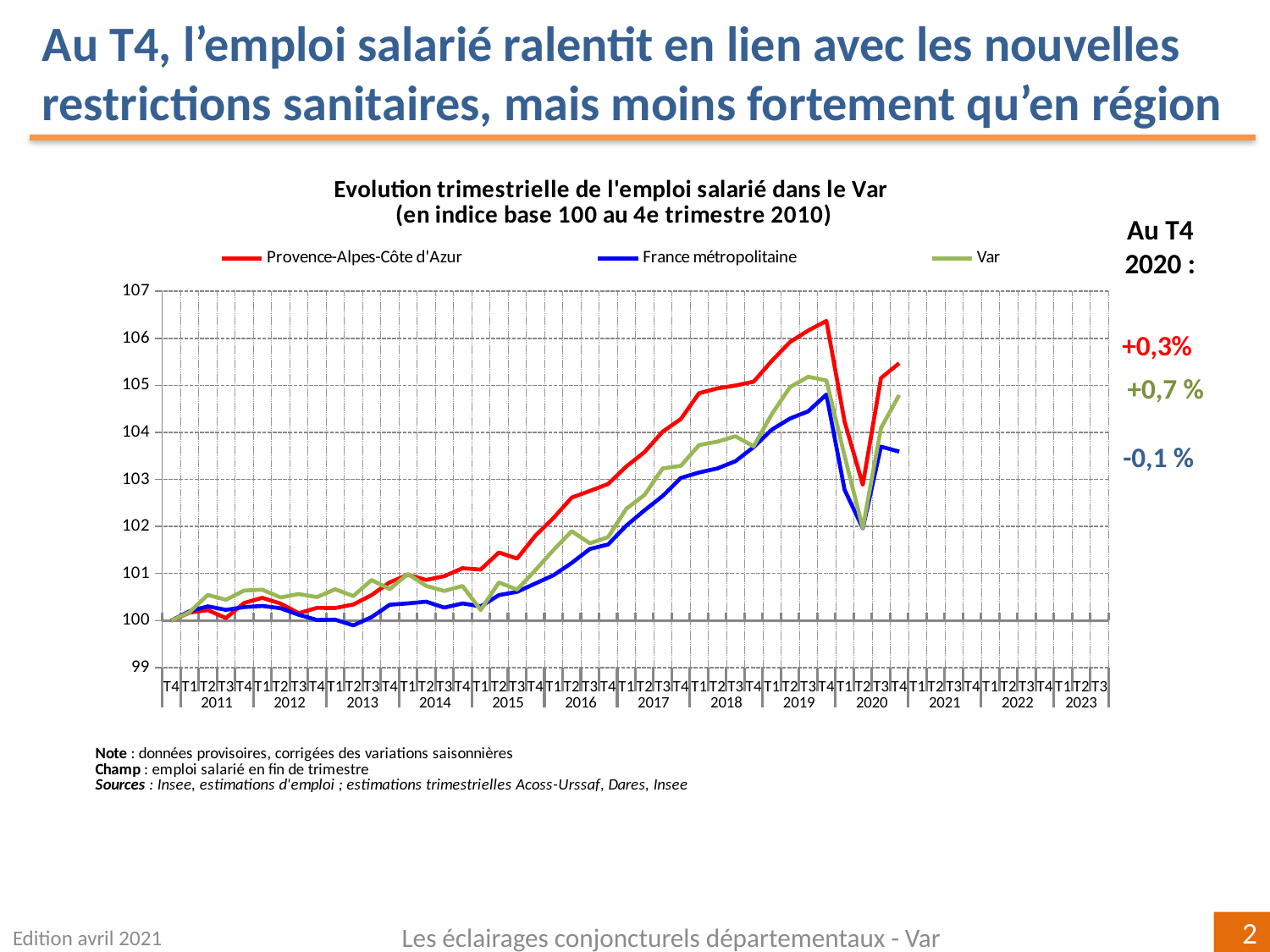
Is the value for Provence-Alpes-Côte d'Azur at T4 2019 greater or less than 106? greater How many series does the legend list? 3 Which series are listed in the legend? Provence-Alpes-Côte d'Azur, France métropolitaine, Var What kind of chart is shown on the slide? line chart According to the annotation for T4 2020, what is the change for France métropolitaine? -0,1 % Overall, do the index values rise or fall from T4 2010 to T4 2019? rise Which series has the lowest index value at T4 2020? France métropolitaine Is the value for France métropolitaine at T4 2020 greater or less than 104? less According to the annotation for T4 2020, what is the change for Var? +0,7 % Which series has the highest index value at T4 2019? Provence-Alpes-Côte d'Azur According to the annotation for T4 2020, what is the change for Provence-Alpes-Côte d'Azur? +0,3% What is the title of the chart? Evolution trimestrielle de l'emploi salarié dans le Var (en indice base 100 au 4e trimestre 2010)